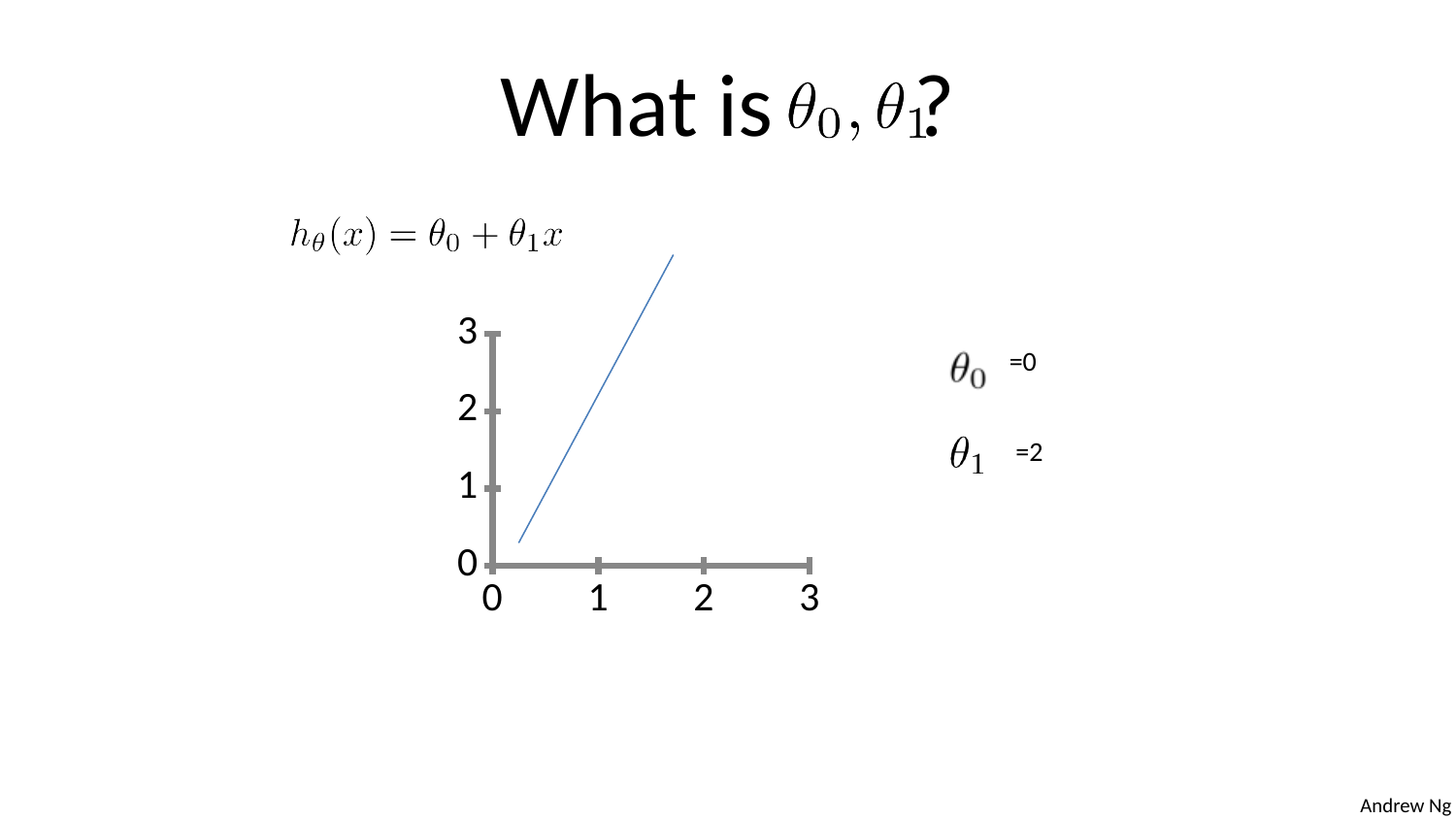
How many tick labels are shown on the x axis of the chart? 4 What kind of chart is shown on the slide? line chart Does the plotted line rise or fall as x increases from 0 to 3? rise Is the value of the plotted line at x = 0.5 greater or less than 2? less What is the highest tick value shown on the y axis of the chart? 3 Is the value of the plotted line at x = 1 greater or less than 1? greater According to the slide, what is the value of θ1 for the plotted line? 2